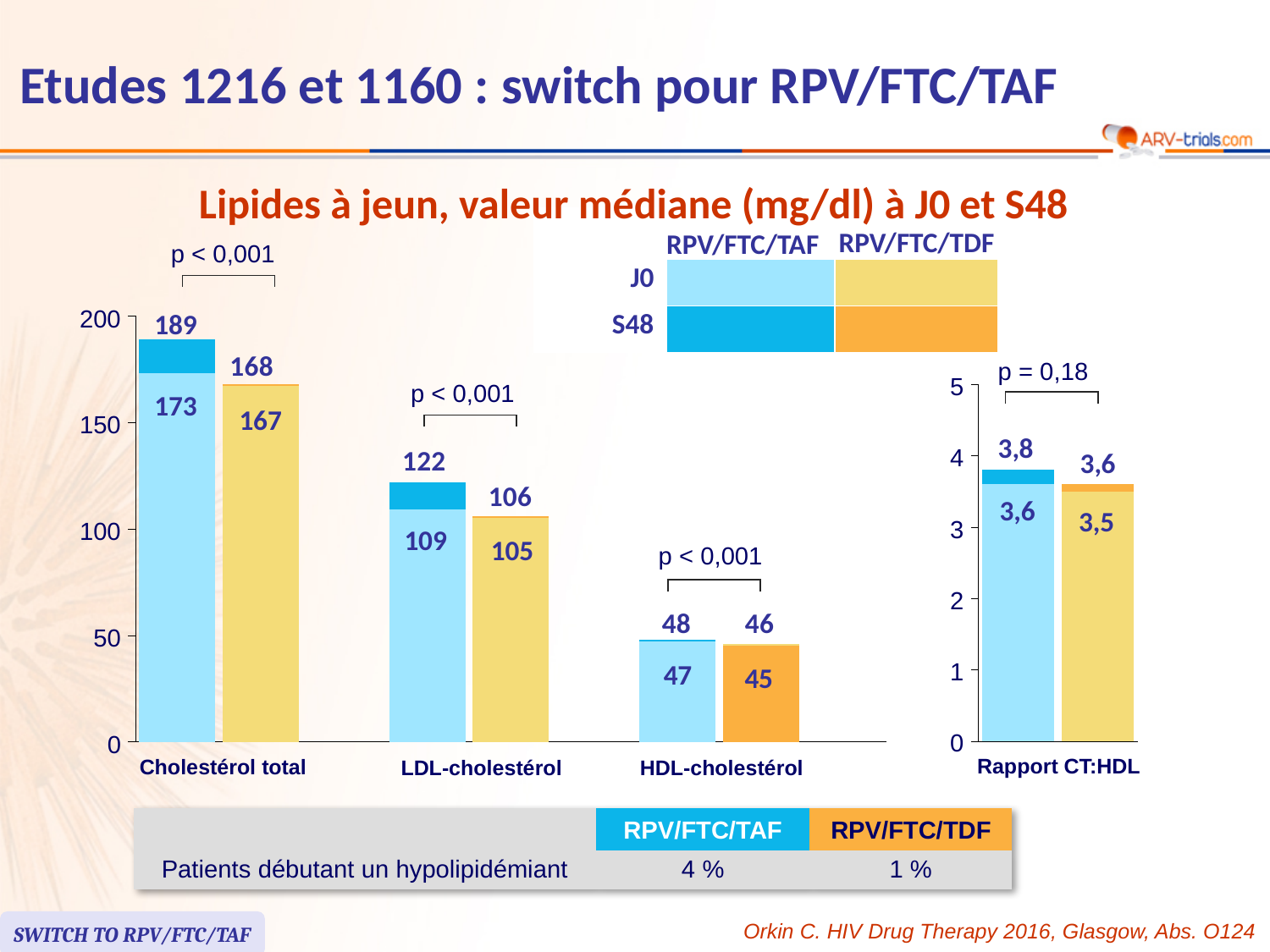
In the right chart (Rapport CT:HDL), what is the J0 value for RPV/FTC/TDF? 3,5 In the left chart, what is the S48 median total cholesterol (Cholestérol total) for RPV/FTC/TAF? 189 In the left chart, which treatment has the higher S48 total cholesterol, RPV/FTC/TAF or RPV/FTC/TDF? RPV/FTC/TAF In the left chart, what is the S48 median LDL-cholestérol value for RPV/FTC/TAF? 122 In the left chart, what is the difference between the S48 LDL-cholestérol values for RPV/FTC/TAF (122) and RPV/FTC/TDF (106)? 16 In the left chart, by how much did the median total cholesterol for RPV/FTC/TAF change from J0 (173) to S48 (189)? 16 In the right chart (Rapport CT:HDL), what is the S48 value for RPV/FTC/TAF? 3,8 What p-value is shown above the Rapport CT:HDL chart? p = 0,18 In the left chart, what is the J0 median total cholesterol (Cholestérol total) for RPV/FTC/TDF? 167 In the left chart, what is the J0 median HDL-cholestérol value for RPV/FTC/TDF? 45 In the left chart, which lipid category has the lowest values? HDL-cholestérol How many lipid categories are shown on the x axis of the left chart? 3